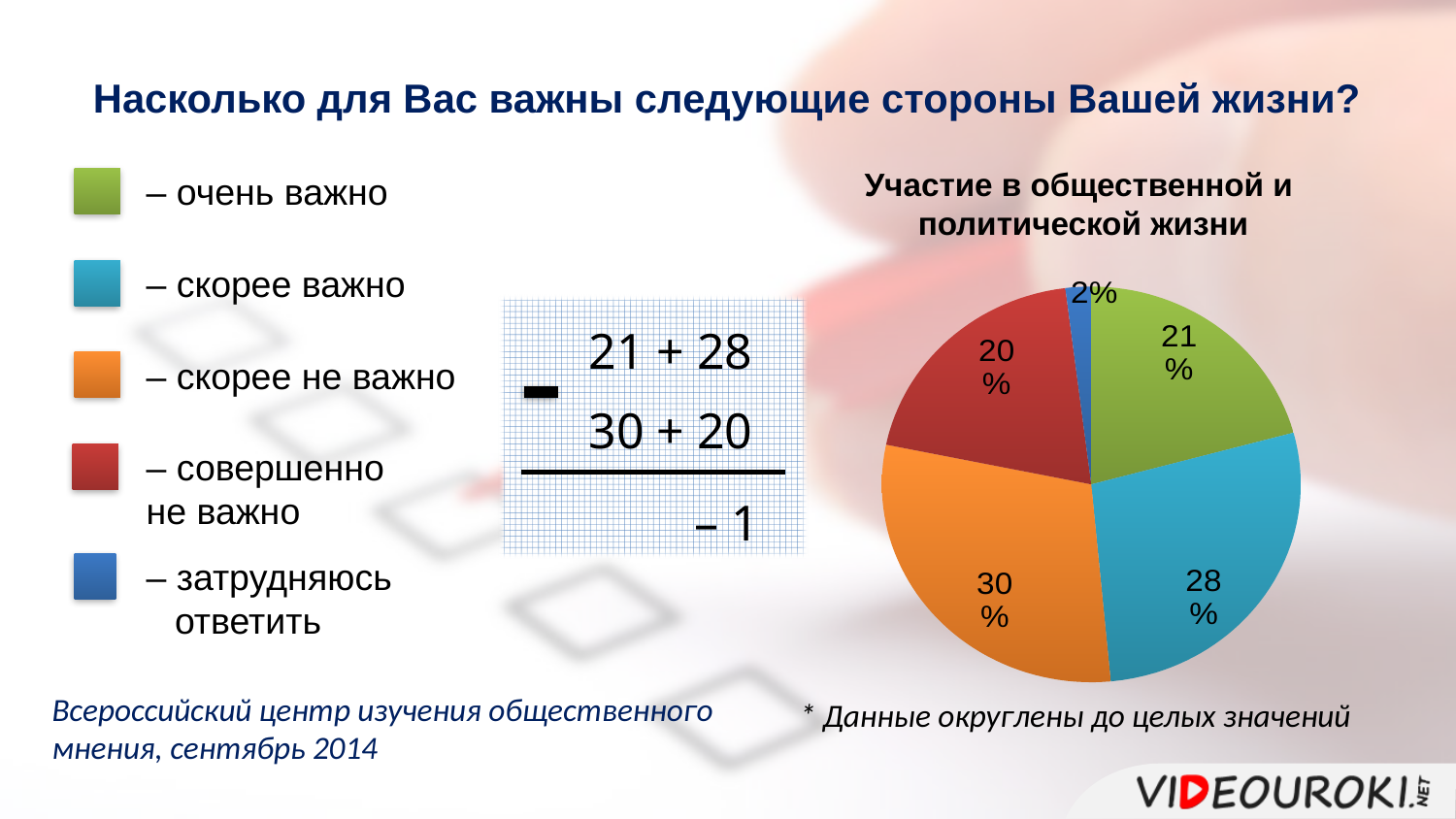
Which category has the smallest slice of the pie? затрудняюсь ответить What kind of chart is shown on the slide? pie chart What share of the pie does the "затрудняюсь ответить" slice take? 2% What share of the pie does the "скорее не важно" slice take? 30% Which is larger: the "скорее важно" slice or the "очень важно" slice? скорее важно What is the difference between the "скорее не важно" and "совершенно не важно" slices? 10% What is the title of the pie chart? Участие в общественной и политической жизни What share of the pie does the "скорее важно" slice take? 28% How many slices does the pie chart have? 5 Which category has the largest slice of the pie? скорее не важно